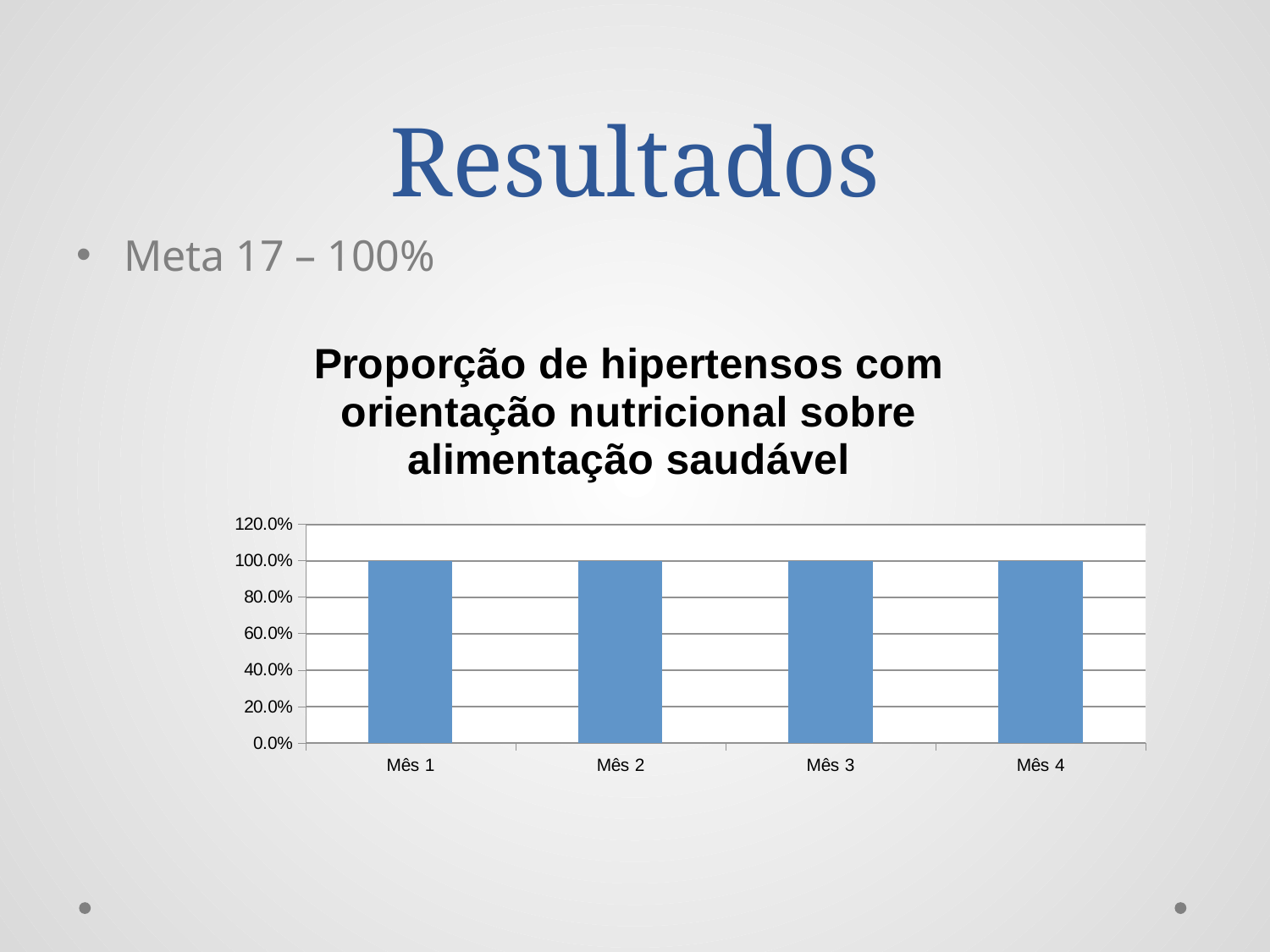
Do the values rise, fall, or stay flat from Mês 1 to Mês 4? stay flat What is the title of the chart? Proporção de hipertensos com orientação nutricional sobre alimentação saudável What type of chart is shown on the slide? bar chart What is the value for Mês 4 in the chart? 100.0% What is the value for Mês 1 in the chart? 100.0% What is the difference between the values for Mês 1 and Mês 4? 0.0% Is the value for Mês 3 greater or less than 80.0%? greater Is the value for Mês 1 greater or less than 120.0%? less What is the highest value shown on the y axis of the chart? 120.0% How many categories (months) are shown on the x axis of the chart? 4 What is the value for Mês 2 in the chart? 100.0% What is the value for Mês 3 in the chart? 100.0%